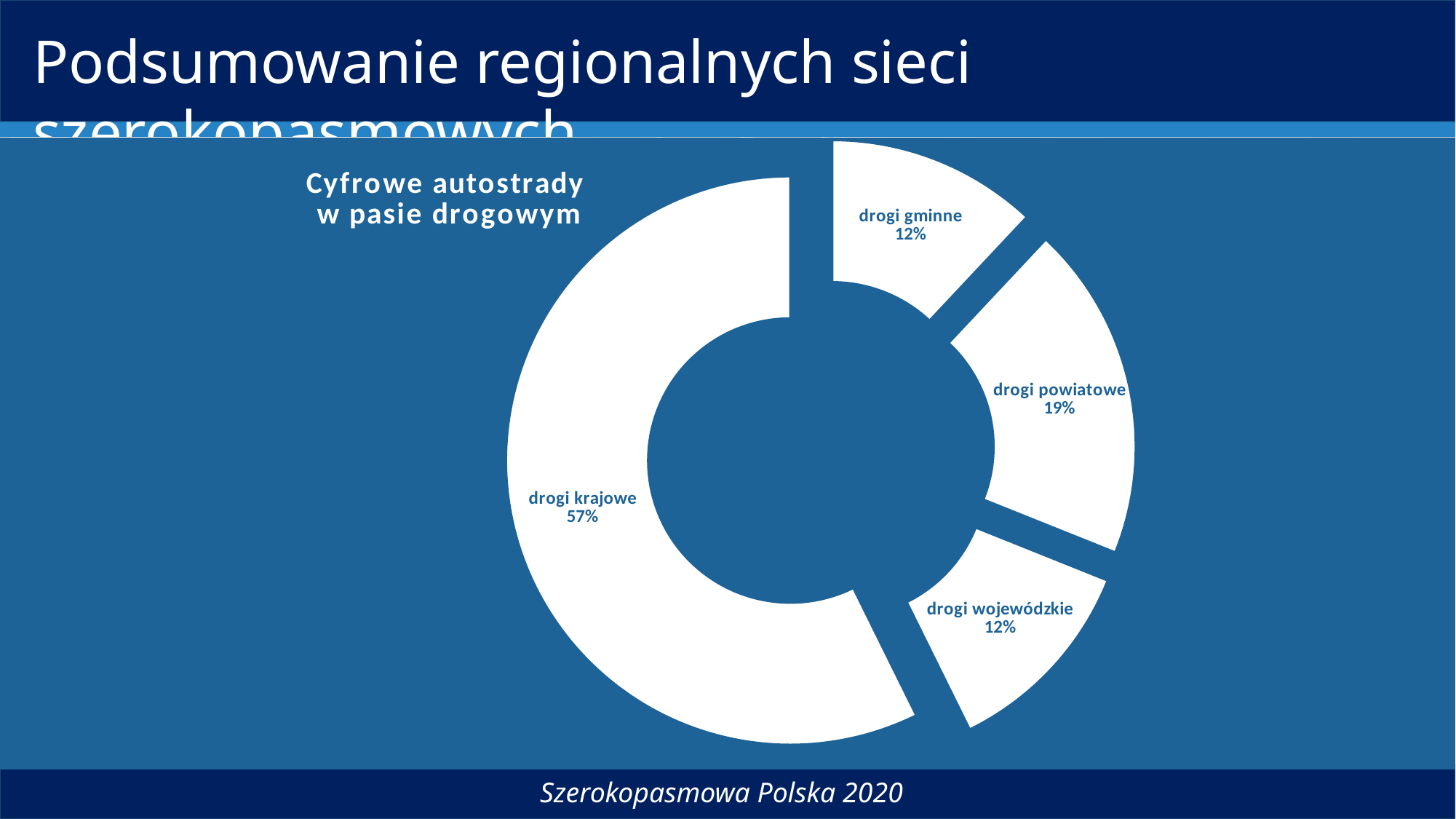
Which category has the larger share, drogi powiatowe or drogi gminne? drogi powiatowe What share of the chart is labelled 'drogi gminne'? 12% How many categories (slices) does the chart show? 4 What share of the chart is labelled 'drogi krajowe'? 57% What kind of chart is shown on the slide? Doughnut (pie) chart Which two categories have the same share of the chart? drogi gminne and drogi wojewódzkie What is the difference in percentage points between the shares of drogi powiatowe and drogi wojewódzkie? 7 What is the difference in percentage points between the shares of drogi krajowe and drogi powiatowe? 38 Which category has the largest share of the chart? drogi krajowe What is the title of the chart? Cyfrowe autostrady w pasie drogowym What share of the chart is labelled 'drogi wojewódzkie'? 12% What share of the chart is labelled 'drogi powiatowe'? 19%